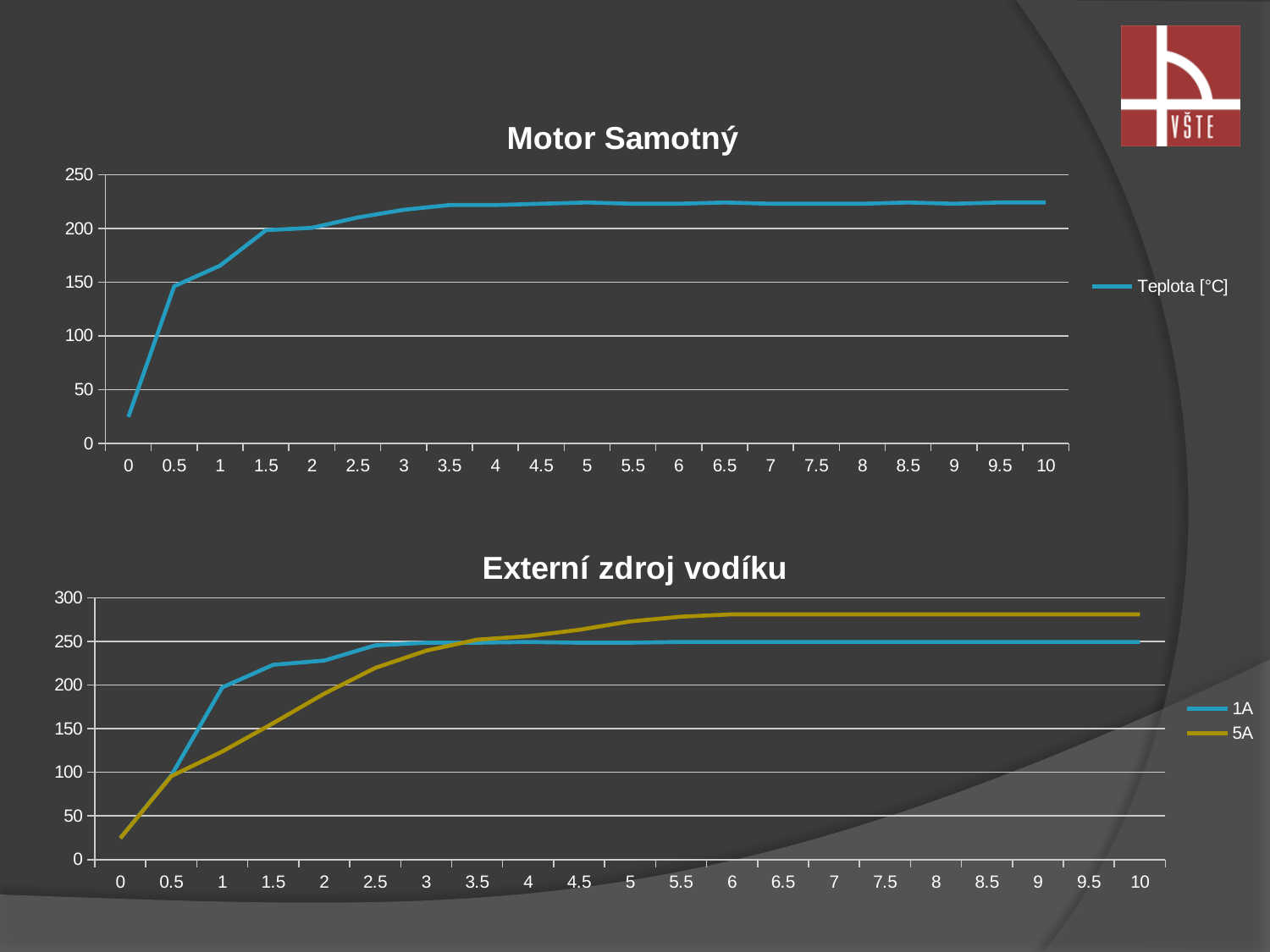
In the "Motor Samotný" chart, is the value at x = 0 greater or less than 50? less How many series does the legend of the "Motor Samotný" chart list? 1 In the "Externí zdroj vodíku" chart, which series has the larger value at x = 2, 1A or 5A? 1A In the "Externí zdroj vodíku" chart, which series has the larger value at x = 10, 1A or 5A? 5A In the "Motor Samotný" chart, is the value at x = 10 greater or less than 200? greater How many points are plotted along the x axis of the "Motor Samotný" chart? 21 In the "Motor Samotný" chart, does the Teplota [°C] value rise or fall along the x axis? rise What is the legend entry of the "Motor Samotný" chart? Teplota [°C] What kind of chart is the "Externí zdroj vodíku" chart? line chart In the "Externí zdroj vodíku" chart, is the 5A value at x = 10 greater or less than 250? greater How many series does the legend of the "Externí zdroj vodíku" chart list? 2 What kind of chart is the "Motor Samotný" chart? line chart